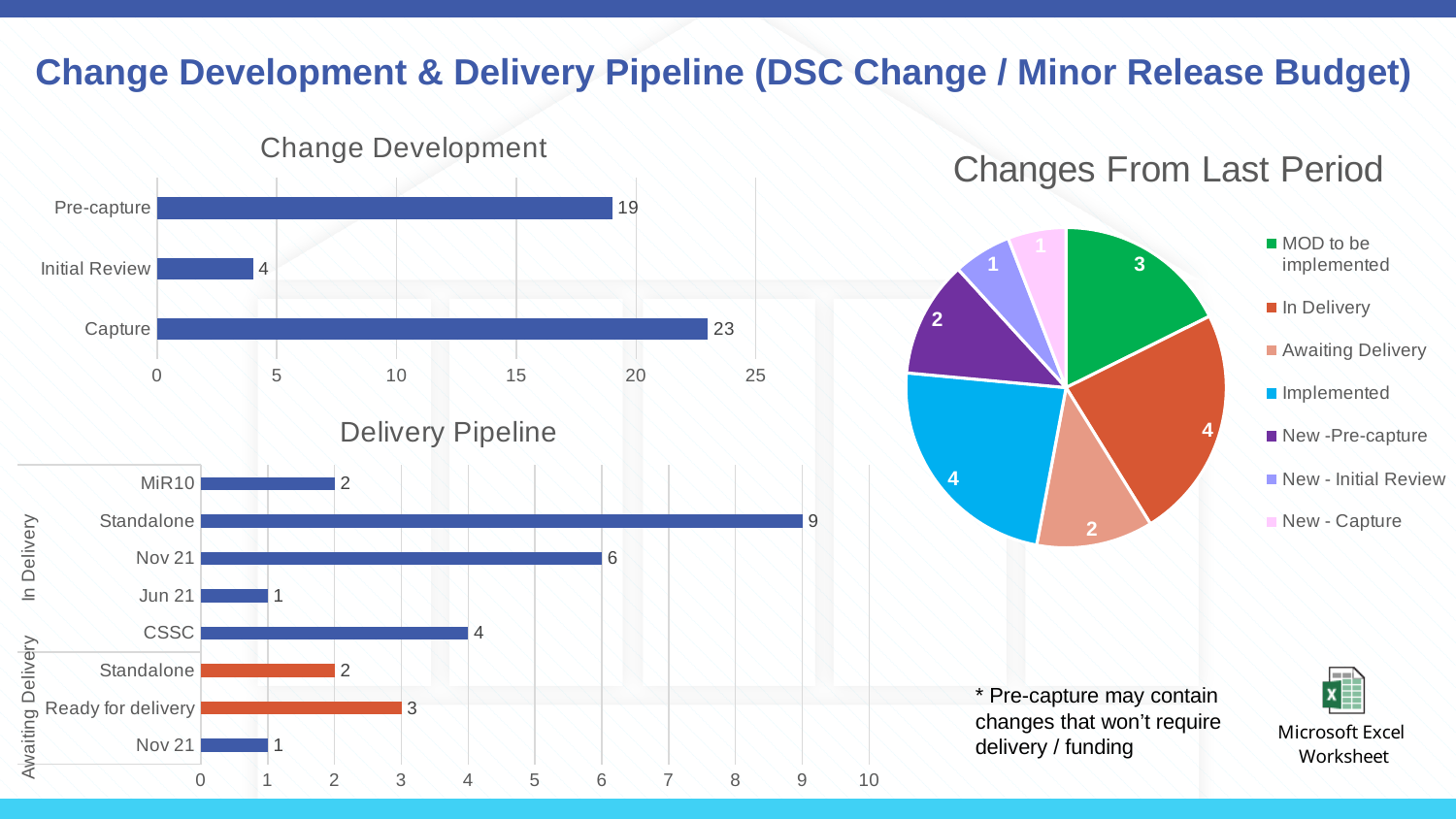
In the Delivery Pipeline chart, which is larger, Nov 21 under In Delivery or CSSC? Nov 21 under In Delivery In the Change Development chart, what is the difference between Capture and Pre-capture? 4 In the Delivery Pipeline chart, which category has the highest value? Standalone (In Delivery) In the Change Development chart, how many categories are shown? 3 In the Delivery Pipeline chart, what is the value for Standalone under In Delivery? 9 In the Change Development chart, which category has the lowest value? Initial Review How many entries does the legend of the Changes From Last Period pie chart list? 7 In the Delivery Pipeline chart, what is the value for Ready for delivery? 3 In the Changes From Last Period pie chart, what is the value for Implemented? 4 In the Change Development chart, what is the value for Capture? 23 In the Changes From Last Period pie chart, what is the total of all slices? 17 What kind of chart is the Delivery Pipeline chart? Bar chart